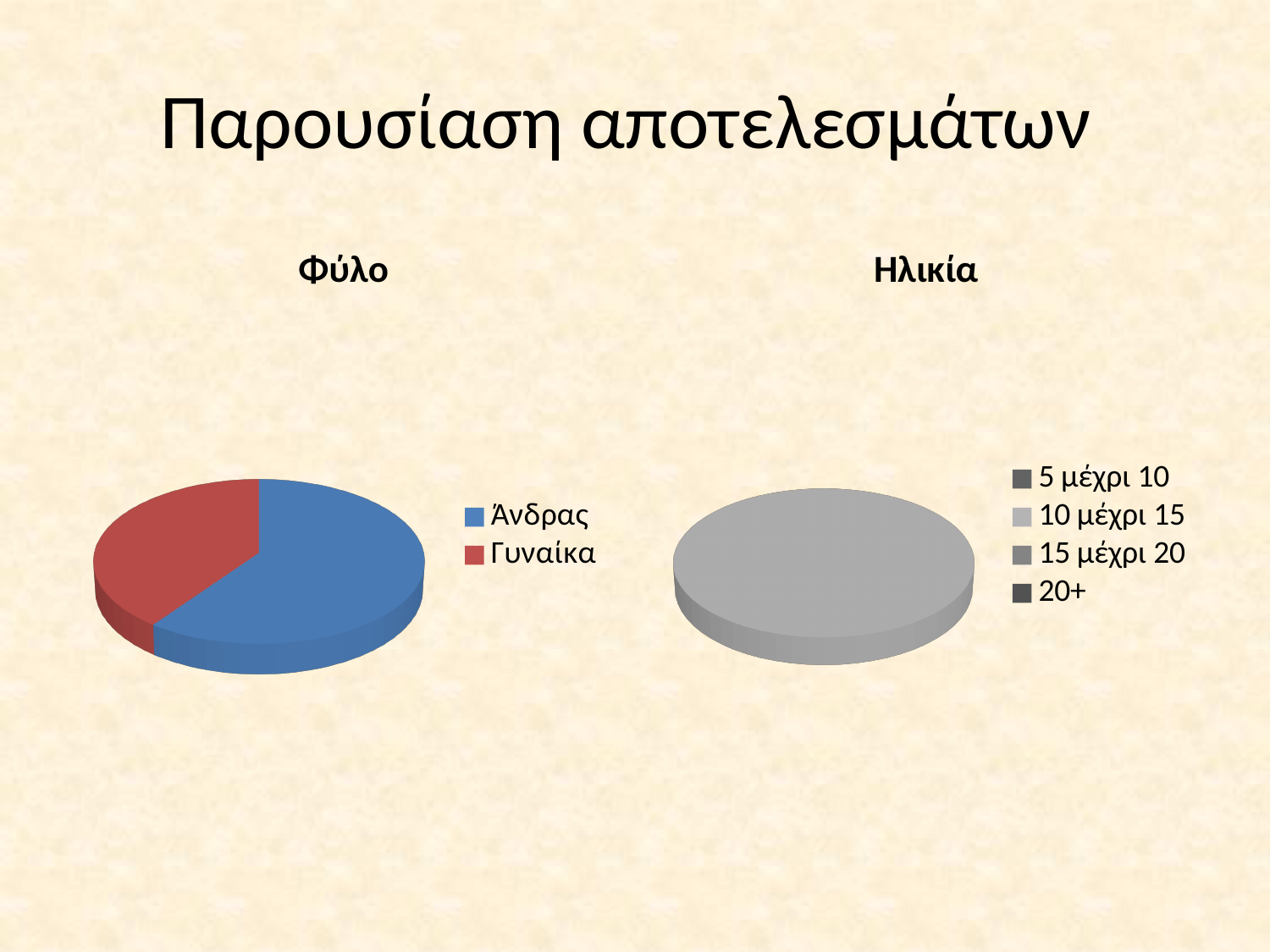
In the "Ηλικία" chart, which category does the entire pie belong to? 10 μέχρι 15 How many categories does the legend of the "Ηλικία" chart list? 4 What kind of chart is the "Ηλικία" chart? pie chart In the "Φύλο" chart, what colour is the Άνδρας slice? blue What is the title of the chart on the right side of the slide? Ηλικία In the "Φύλο" chart, which slice is larger, Άνδρας or Γυναίκα? Άνδρας In the "Φύλο" chart, which category has the largest slice? Άνδρας How many categories does the legend of the "Φύλο" chart list? 2 In the "Φύλο" chart, which category has the smallest slice? Γυναίκα What kind of chart is the "Φύλο" chart? pie chart